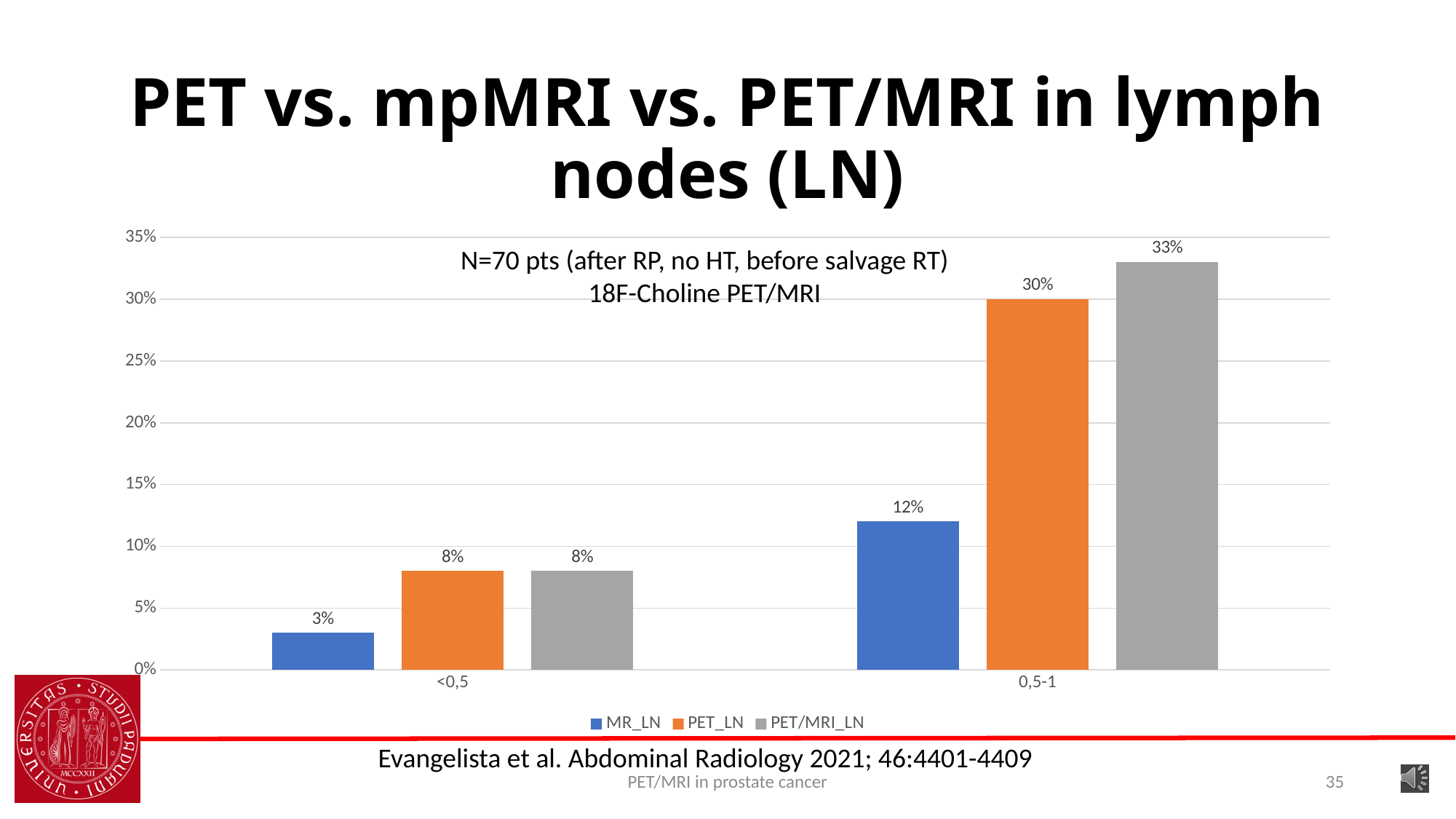
What is the value for PET_LN in the 0,5-1 category? 30% Which series has the highest value in the 0,5-1 category? PET/MRI_LN How many categories are shown on the x axis? 2 How many series does the legend list? 3 Is the value for PET/MRI_LN in the 0,5-1 category greater or less than 30%? greater What is the value for PET/MRI_LN in the 0,5-1 category? 33% Which is larger: MR_LN in the 0,5-1 category or PET_LN in the <0,5 category? MR_LN in the 0,5-1 category What kind of chart is shown on the slide? Bar chart What is the value for MR_LN in the <0,5 category? 3% What colour represents the PET_LN series? Orange What is the difference between the PET_LN and MR_LN values in the 0,5-1 category? 18% Which series has the lowest value in the <0,5 category? MR_LN